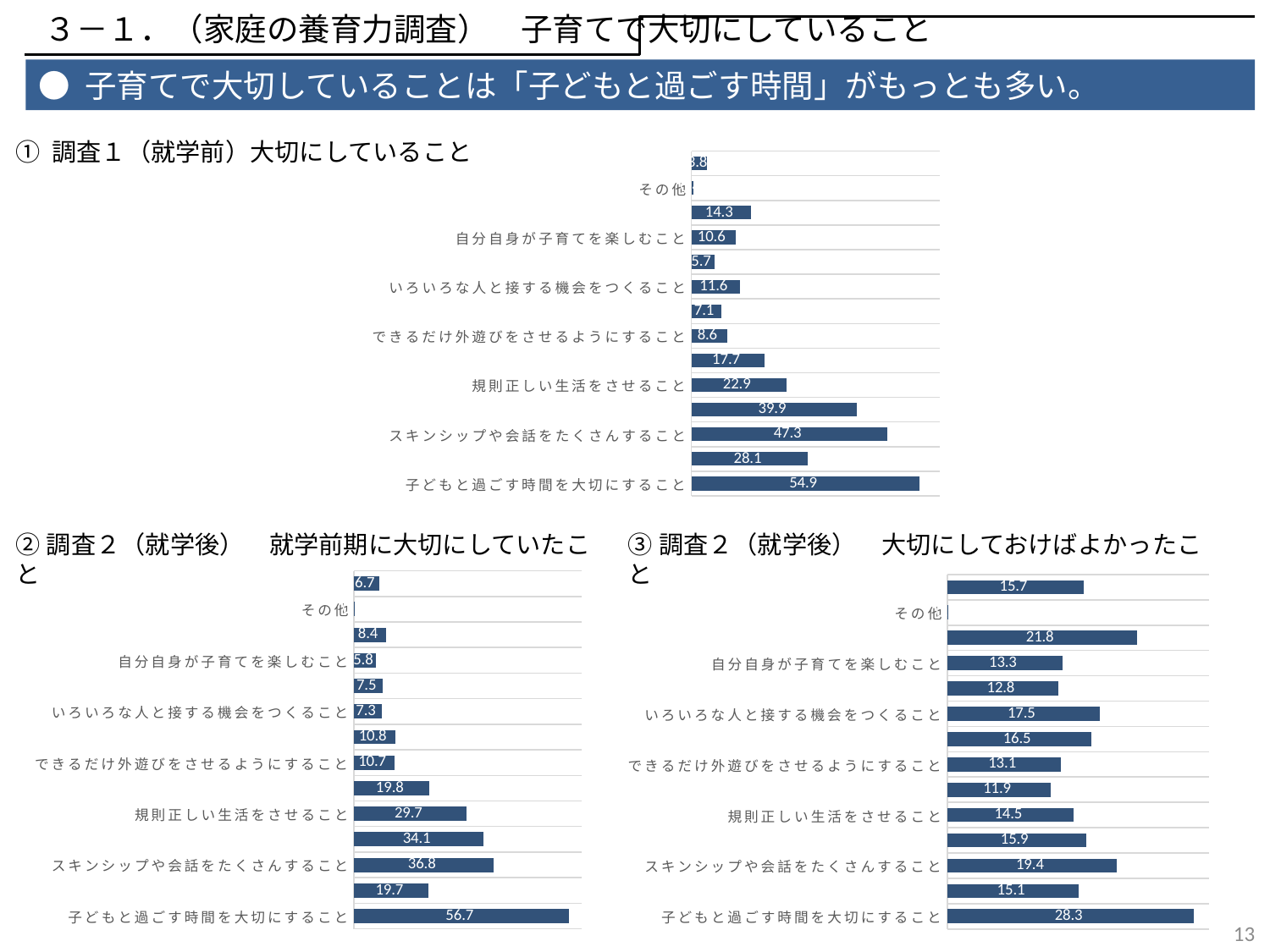
In chart ② 調査２（就学後）就学前期に大切にしていたこと, which is larger: 自分自身が子育てを楽しむこと or できるだけ外遊びをさせるようにすること? できるだけ外遊びをさせるようにすること How many bars (categories) are plotted in chart ② 調査２（就学後）就学前期に大切にしていたこと? 14 In chart ② 調査２（就学後）就学前期に大切にしていたこと, what is the value for 子どもと過ごす時間を大切にすること? 56.7 In chart ② 調査２（就学後）就学前期に大切にしていたこと, what is the value for 規則正しい生活をさせること? 29.7 In chart ③ 調査２（就学後）大切にしておけばよかったこと, what is the value for 子どもと過ごす時間を大切にすること? 28.3 In chart ③ 調査２（就学後）大切にしておけばよかったこと, what is the value for いろいろな人と接する機会をつくること? 17.5 In chart ① 調査１（就学前）大切にしていること, what is the value for 子どもと過ごす時間を大切にすること? 54.9 In chart ③ 調査２（就学後）大切にしておけばよかったこと, what is the difference between 子どもと過ごす時間を大切にすること and スキンシップや会話をたくさんすること? 8.9 What kind of chart is chart ① 調査１（就学前）大切にしていること? Bar chart In chart ① 調査１（就学前）大切にしていること, what is the difference between 子どもと過ごす時間を大切にすること and スキンシップや会話をたくさんすること? 7.6 In chart ① 調査１（就学前）大切にしていること, what is the value for スキンシップや会話をたくさんすること? 47.3 In chart ① 調査１（就学前）大切にしていること, which labeled category has the highest value? 子どもと過ごす時間を大切にすること